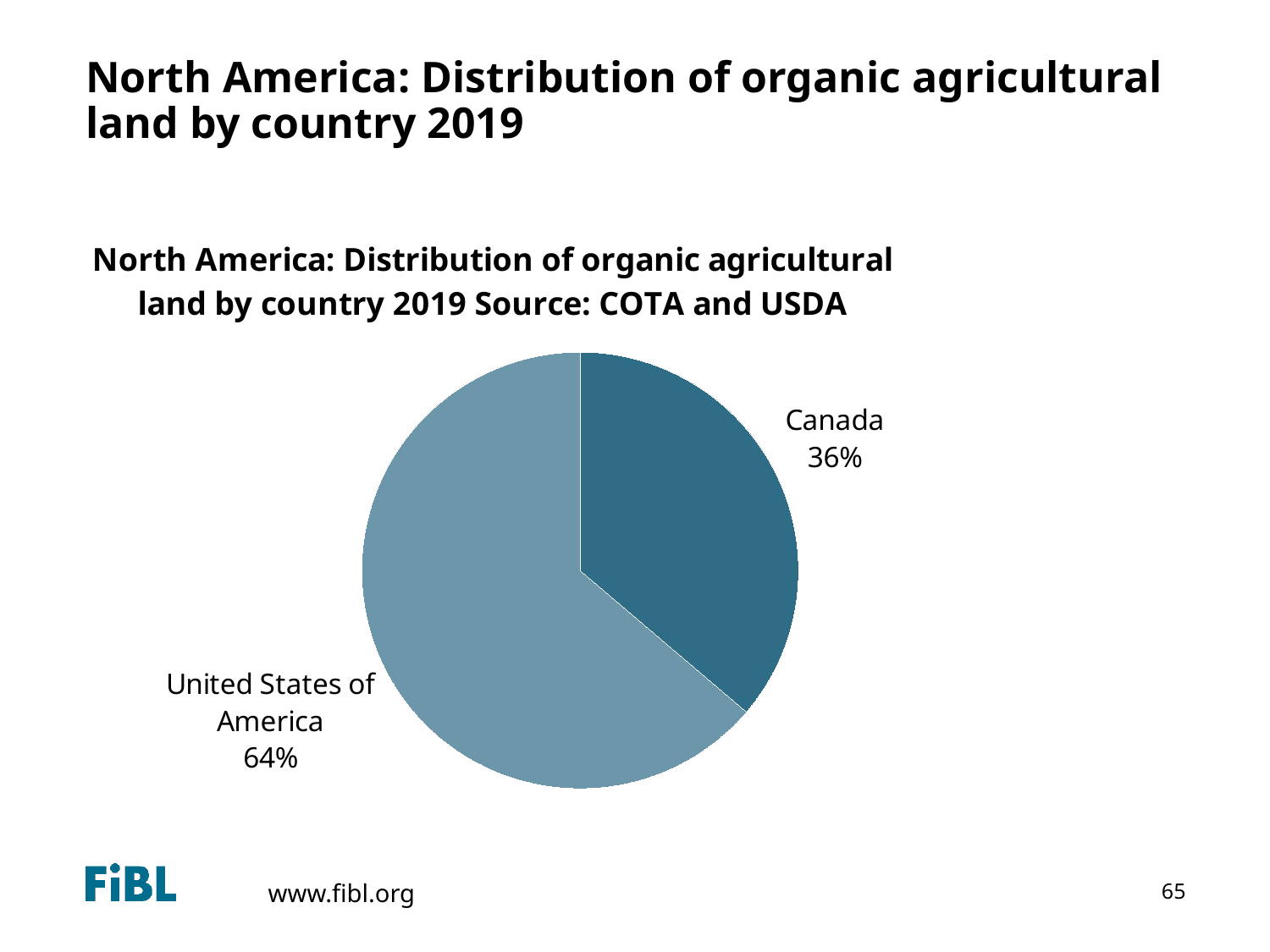
What sources are cited in the chart title? COTA and USDA Which has a larger share of organic agricultural land, Canada or the United States of America? United States of America Which country has the smallest share of organic agricultural land in the pie chart? Canada What share of North America's organic agricultural land does Canada hold according to the pie chart? 36% How many countries are shown in the pie chart? 2 Which country has the largest share of organic agricultural land in the pie chart? United States of America What is the difference in percentage points between the United States of America's share and Canada's share? 28 What share of North America's organic agricultural land does the United States of America hold according to the pie chart? 64% What is the combined share of Canada and the United States of America in the pie chart? 100% What type of chart is shown on the slide? Pie chart What is the title of the chart? North America: Distribution of organic agricultural land by country 2019 Source: COTA and USDA